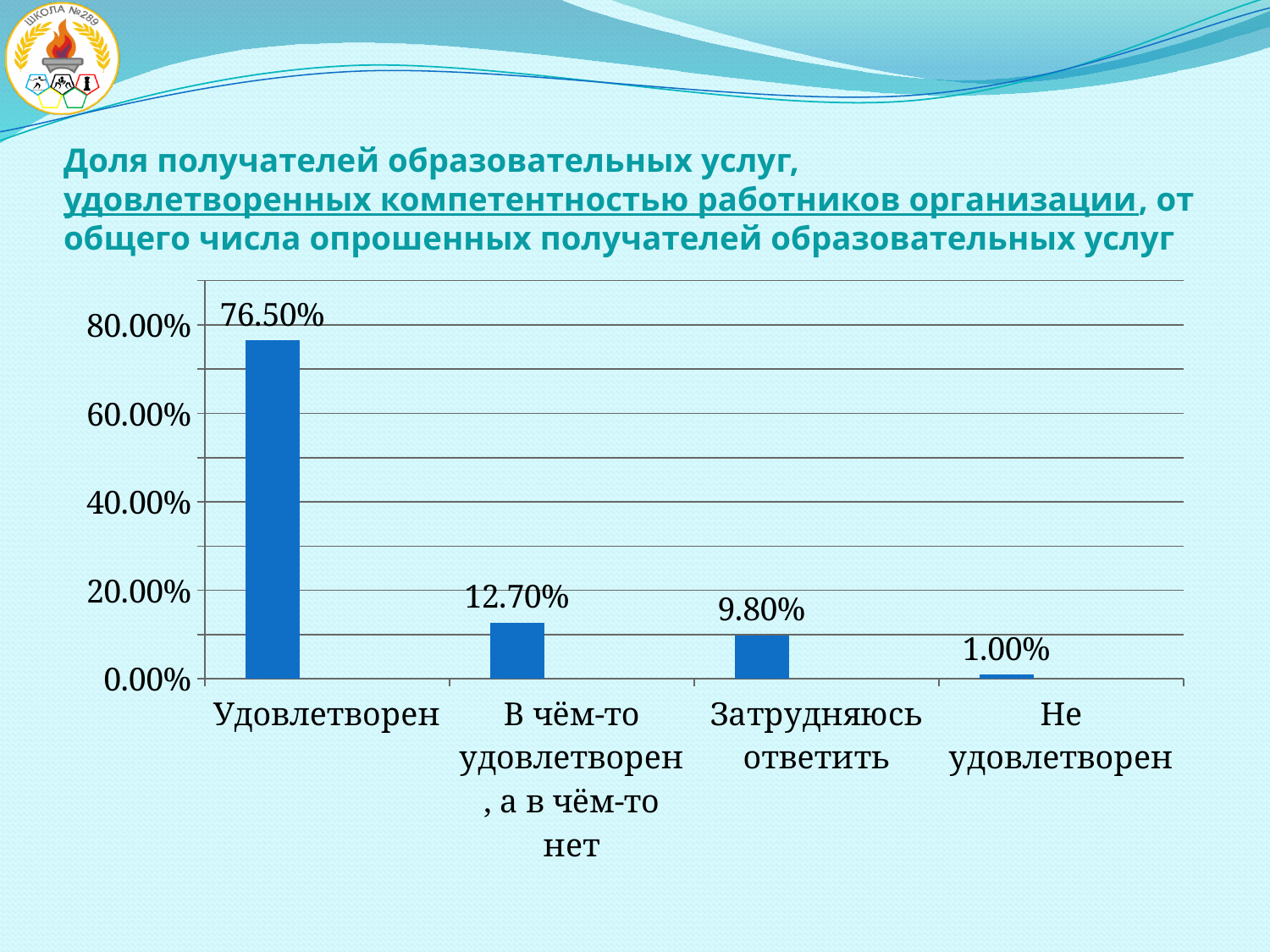
Which category has the highest value? Удовлетворен What is the value for Затрудняюсь ответить? 9.80% What is the value for В чём-то удовлетворен, а в чём-то нет? 12.70% What is the value for Не удовлетворен? 1.00% What is the difference between the values for В чём-то удовлетворен, а в чём-то нет and Затрудняюсь ответить? 2.90% Which is larger, the value for Затрудняюсь ответить or the value for В чём-то удовлетворен, а в чём-то нет? В чём-то удовлетворен, а в чём-то нет What kind of chart is shown on the slide? bar chart Is the value for Удовлетворен greater or less than 60.00%? greater What is the difference between the values for Удовлетворен and Не удовлетворен? 75.50% How many categories are shown on the x axis? 4 Which category has the lowest value? Не удовлетворен What is the value for Удовлетворен? 76.50%